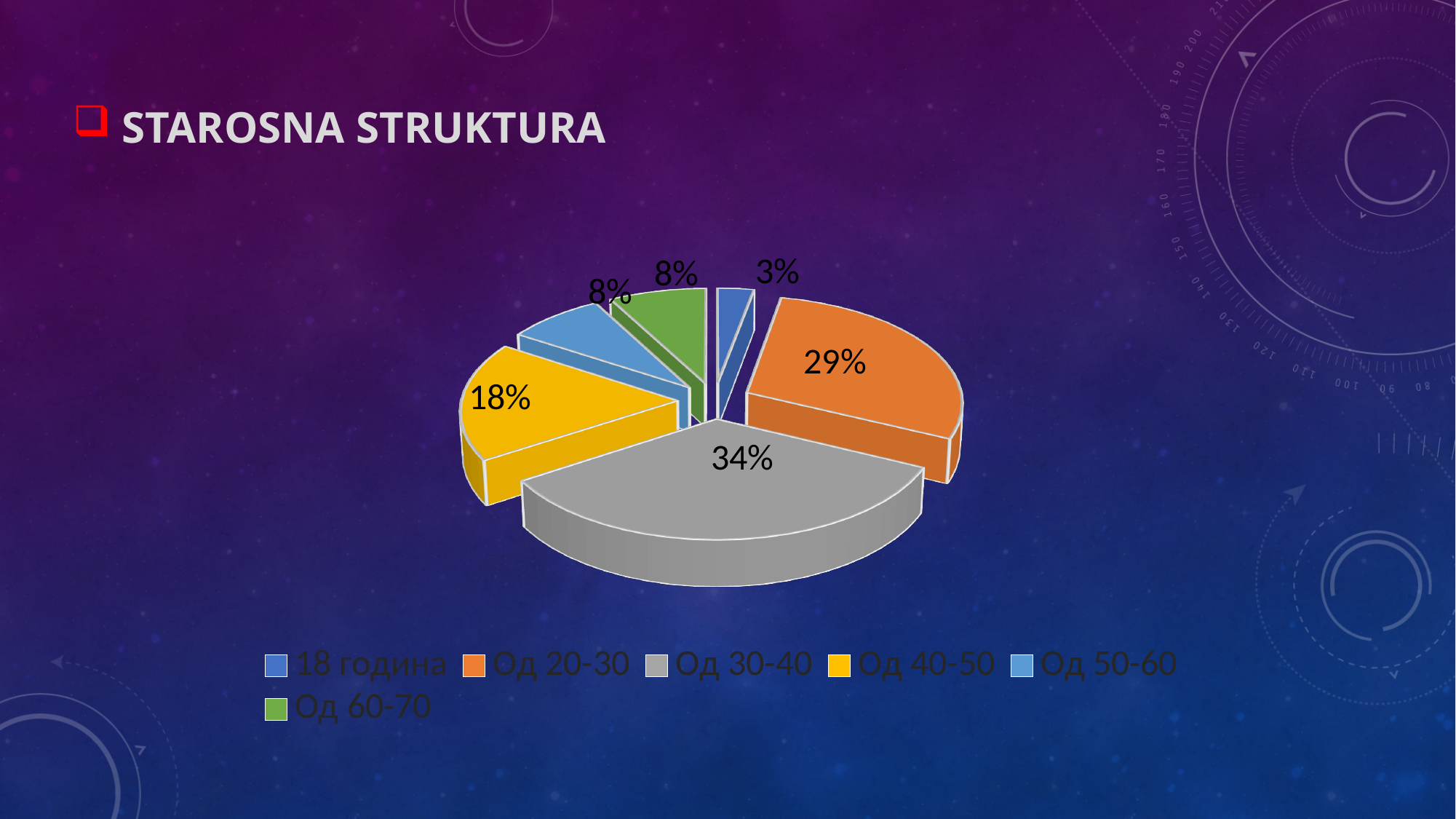
What share of the pie does the "18 година" slice have? 3% What is the difference between the shares of "Од 30-40" and "Од 20-30"? 5% Which category has the smallest slice of the pie? 18 година What kind of chart is shown on the slide? Pie chart What share of the pie does the "Од 20-30" slice have? 29% What share of the pie does the "Од 60-70" slice have? 8% How many categories does the pie chart have? 6 Which category has the largest slice of the pie? Од 30-40 What is the title of the slide containing the pie chart? STAROSNA STRUKTURA Which is larger, the share for "Од 40-50" or the share for "Од 50-60"? Од 40-50